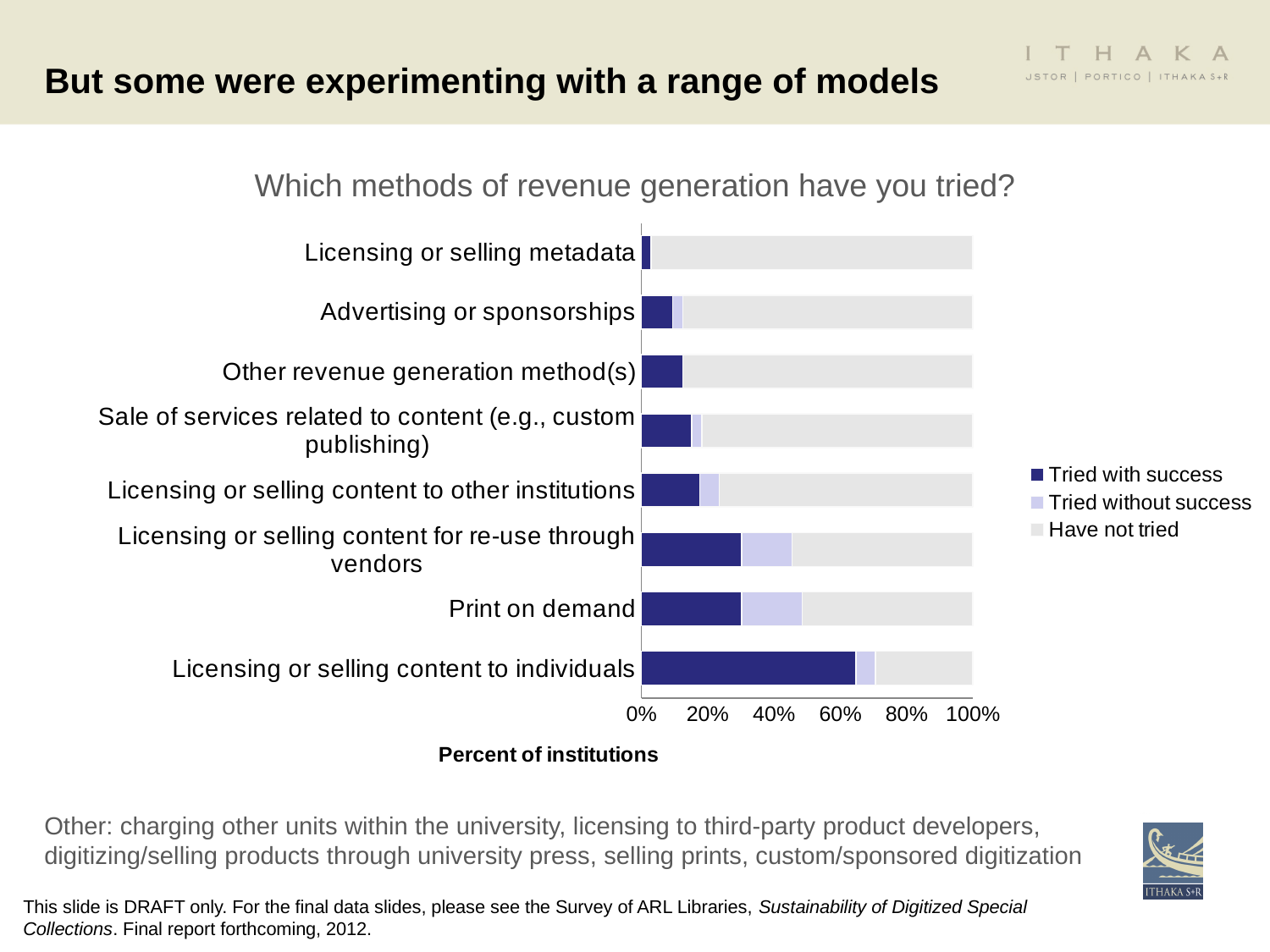
Which method has the smallest 'Tried with success' share? Licensing or selling metadata How many series does the chart's legend list? 3 Which method has the largest 'Tried with success' share? Licensing or selling content to individuals Is the 'Tried with success' value for Licensing or selling content for re-use through vendors greater or less than 20%? greater What is the label of the horizontal axis? Percent of institutions What kind of chart is shown on the slide? bar chart Which has a larger 'Tried with success' share: Print on demand or Licensing or selling content to individuals? Licensing or selling content to individuals Is the 'Tried with success' value for Licensing or selling metadata greater or less than 20%? less How many revenue generation methods (categories) are listed on the chart? 8 Is the 'Tried with success' value for Licensing or selling content to individuals greater or less than 60%? greater What is the title of the chart? Which methods of revenue generation have you tried?